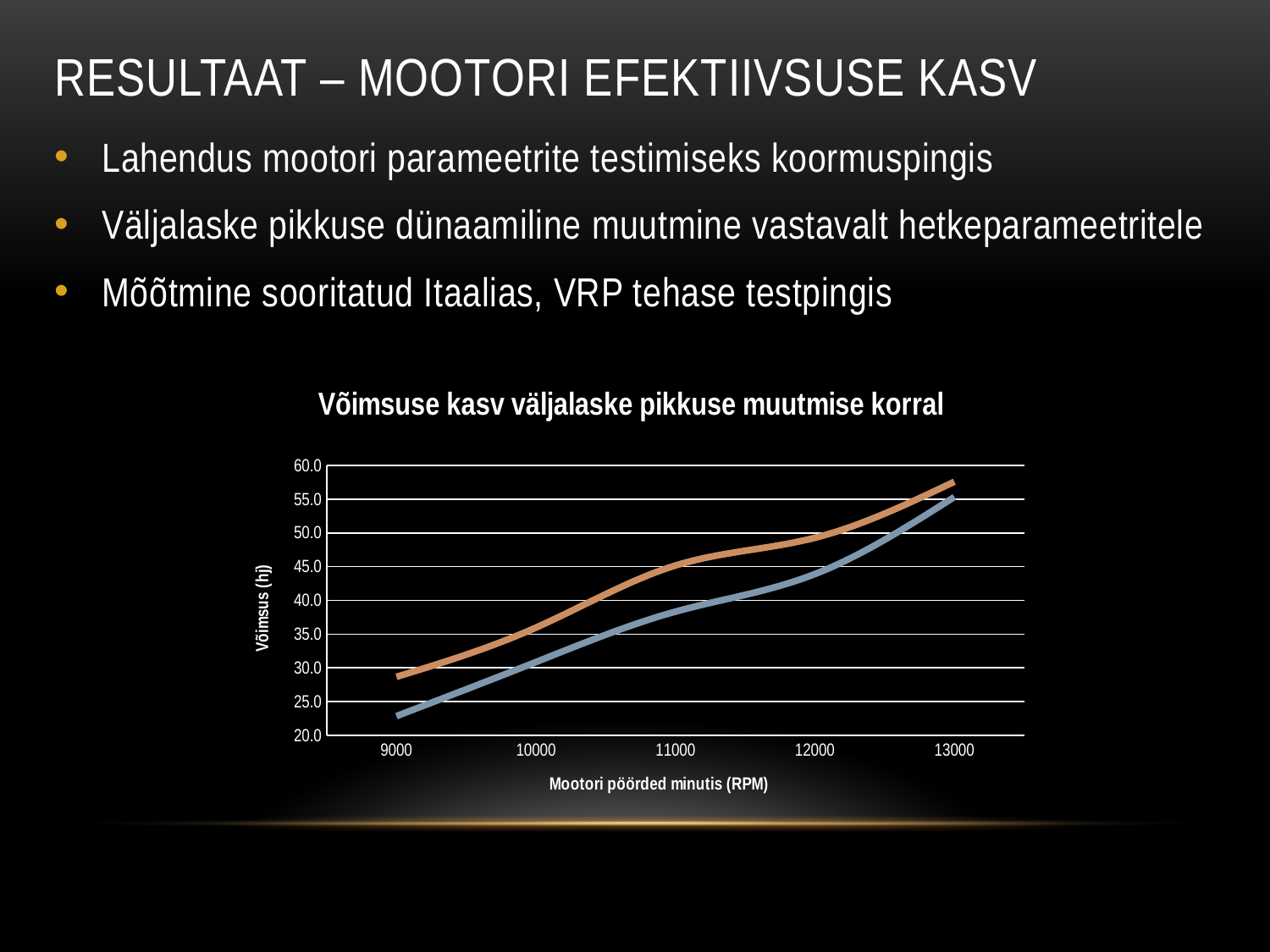
What is the label of the x axis of the chart? Mootori pöörded minutis (RPM) Is the value of the blue line at 12000 RPM greater or less than 45.0? less What kind of chart is shown on the slide? line chart How many lines are plotted on the chart? 2 What is the title of the chart? Võimsuse kasv väljalaske pikkuse muutmise korral Is the value of the orange line at 13000 RPM greater or less than 55.0? greater How many RPM values are marked on the x axis of the chart? 5 At 11000 RPM, which line has the higher value, the orange line or the blue line? the orange line Do the values of the blue line rise or fall as RPM increases? rise Is the value of the blue line at 9000 RPM greater or less than 25.0? less Do the values of the orange line rise or fall as RPM increases? rise